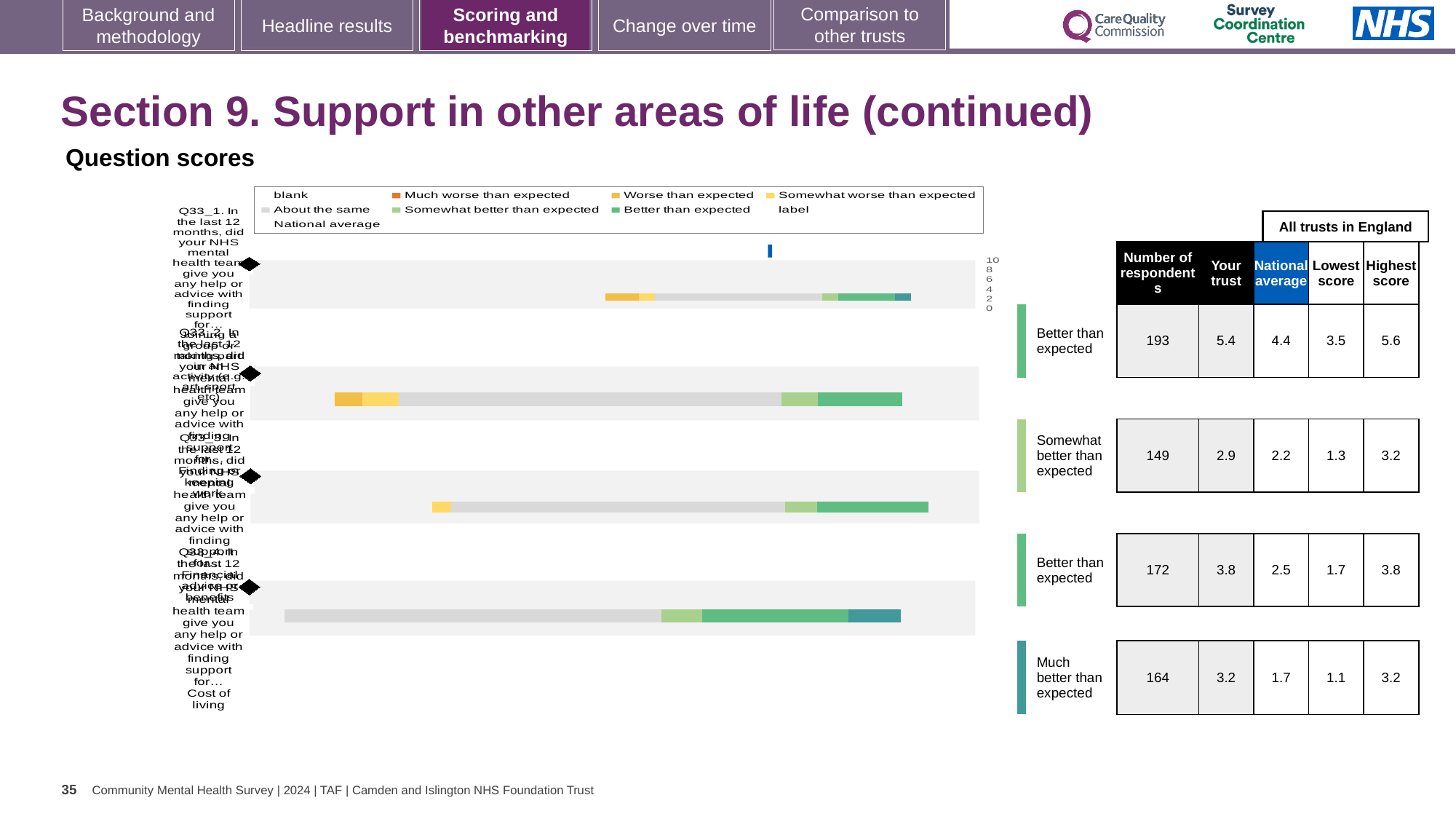
What is the smallest 'Lowest score' value shown in the table? 1.1 What type of chart is shown under 'Question scores'? bar chart In the first row of the table, which is larger: the 'Your trust' score or the 'National average'? Your trust In the first row of the table, what is the difference between the 'Your trust' score (5.4) and the 'National average' (4.4)? 1.0 How many question bars are plotted in the chart? 4 What colour does the legend use for 'About the same'? grey Which row of the table has the highest number of respondents? the first row (193) In the table beside the chart, what is the 'Your trust' score in the first row? 5.4 What rating label is shown next to the third row of the table? Better than expected In the table beside the chart, what is the number of respondents in the first row? 193 In the table beside the chart, what is the 'Highest score' in the last row? 3.2